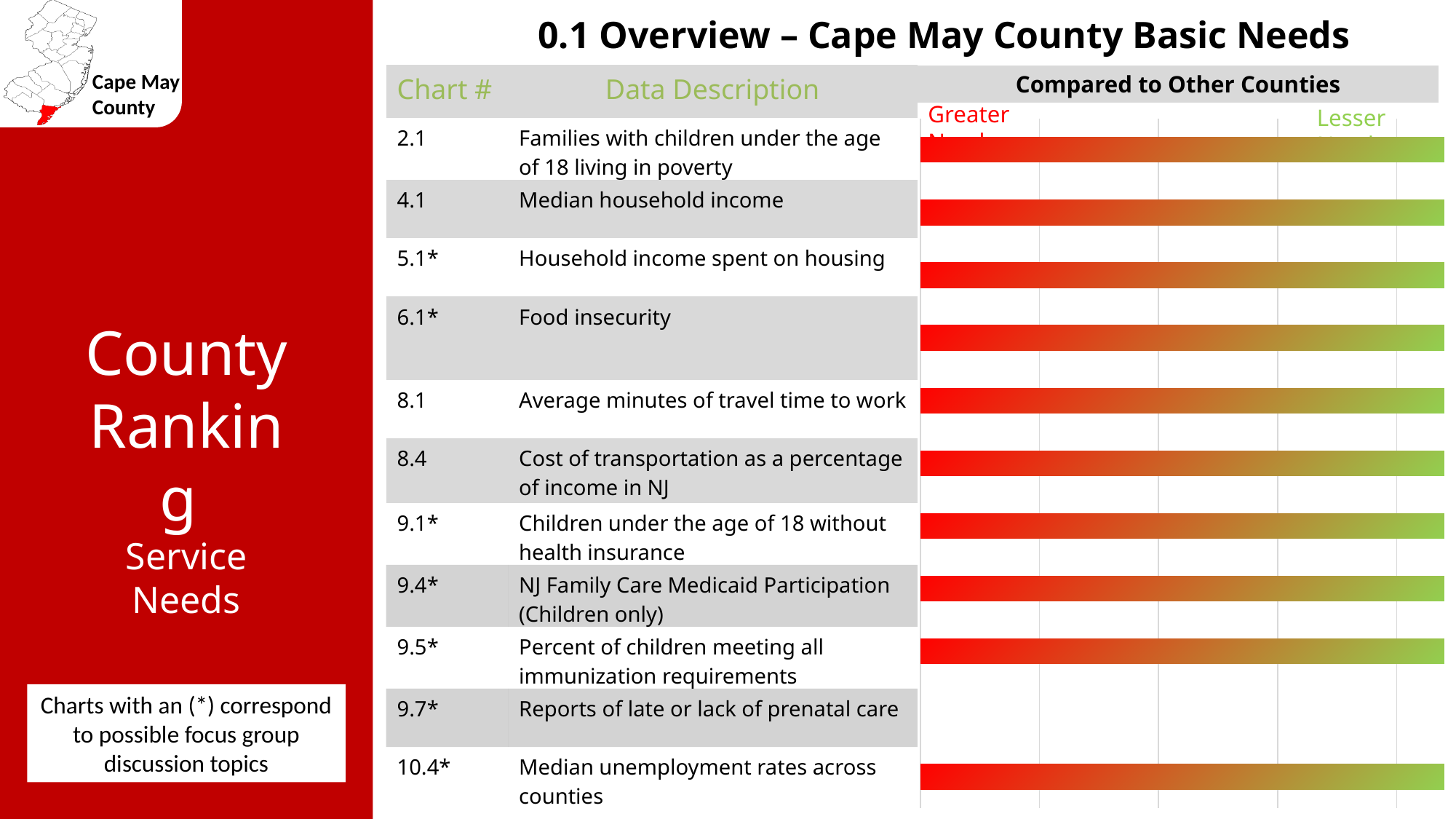
What is the heading above the bar chart on the right side of the slide? Compared to Other Counties What kind of chart is shown under the heading "Compared to Other Counties"? bar chart Which chart number corresponds to the data description "Food insecurity"? 6.1* Which end of the bars is labelled "Greater" need, the left or the right? left What data description is listed for chart number 10.4*? Median unemployment rates across counties How many of the listed chart numbers are marked with an asterisk (*)? 7 Which chart number corresponds to "Median household income"? 4.1 What data description is listed for chart number 8.1? Average minutes of travel time to work How many data descriptions are listed in the table alongside the bar chart? 11